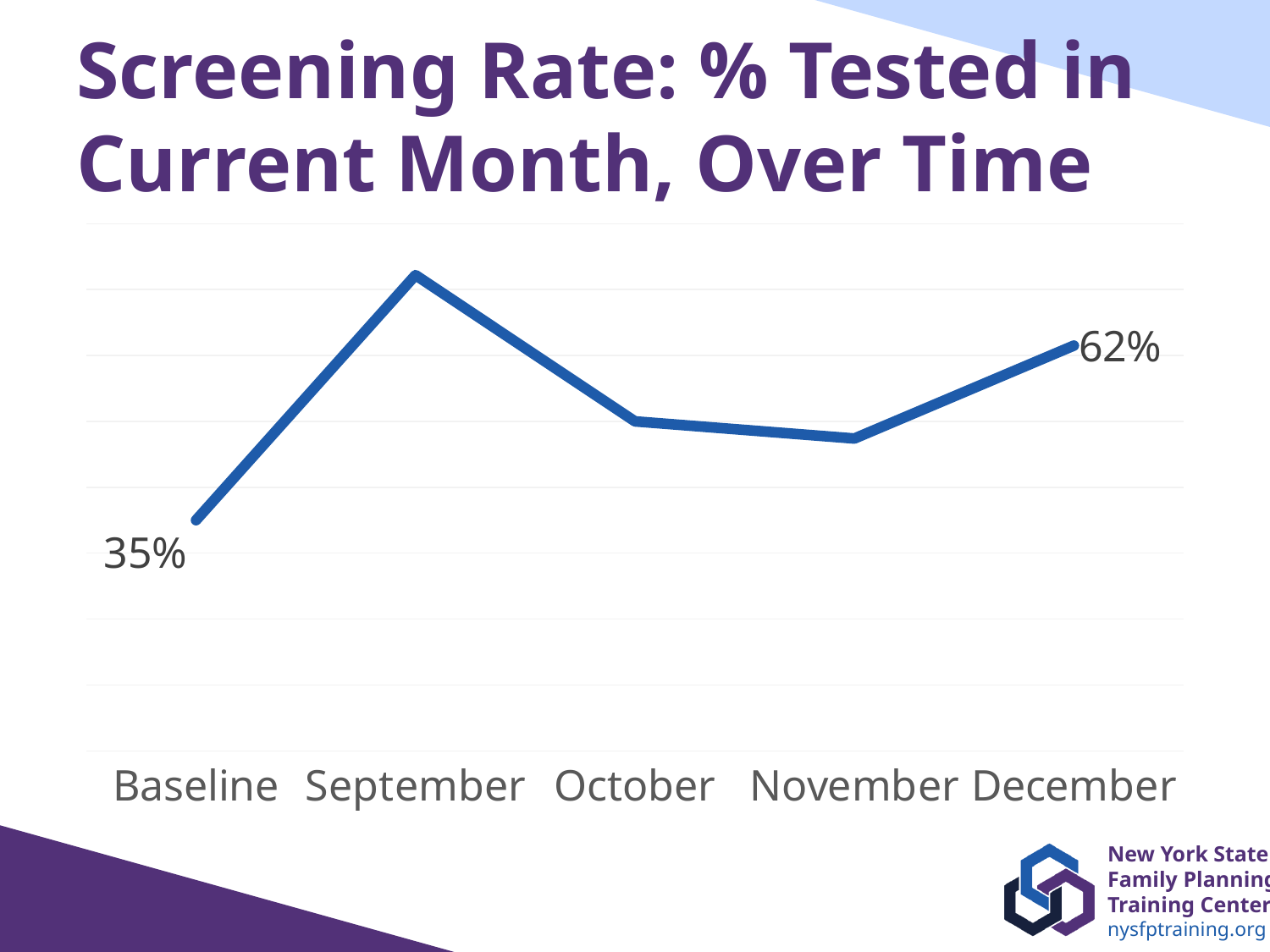
Does the screening rate rise or fall from September to October? fall Which is higher, the screening rate in September or in October? September What is the title of the chart on the slide? Screening Rate: % Tested in Current Month, Over Time How many time points are plotted on the chart? 5 What type of chart is shown on the slide? line chart Does the screening rate rise or fall from November to December? rise What is the screening rate in December? 62% Which point on the chart has the highest screening rate? September What is the screening rate at Baseline? 35% By how many percentage points does the December screening rate exceed the Baseline rate? 27 percentage points Which point on the chart has the lowest screening rate? Baseline Which is higher, the screening rate at Baseline or in December? December